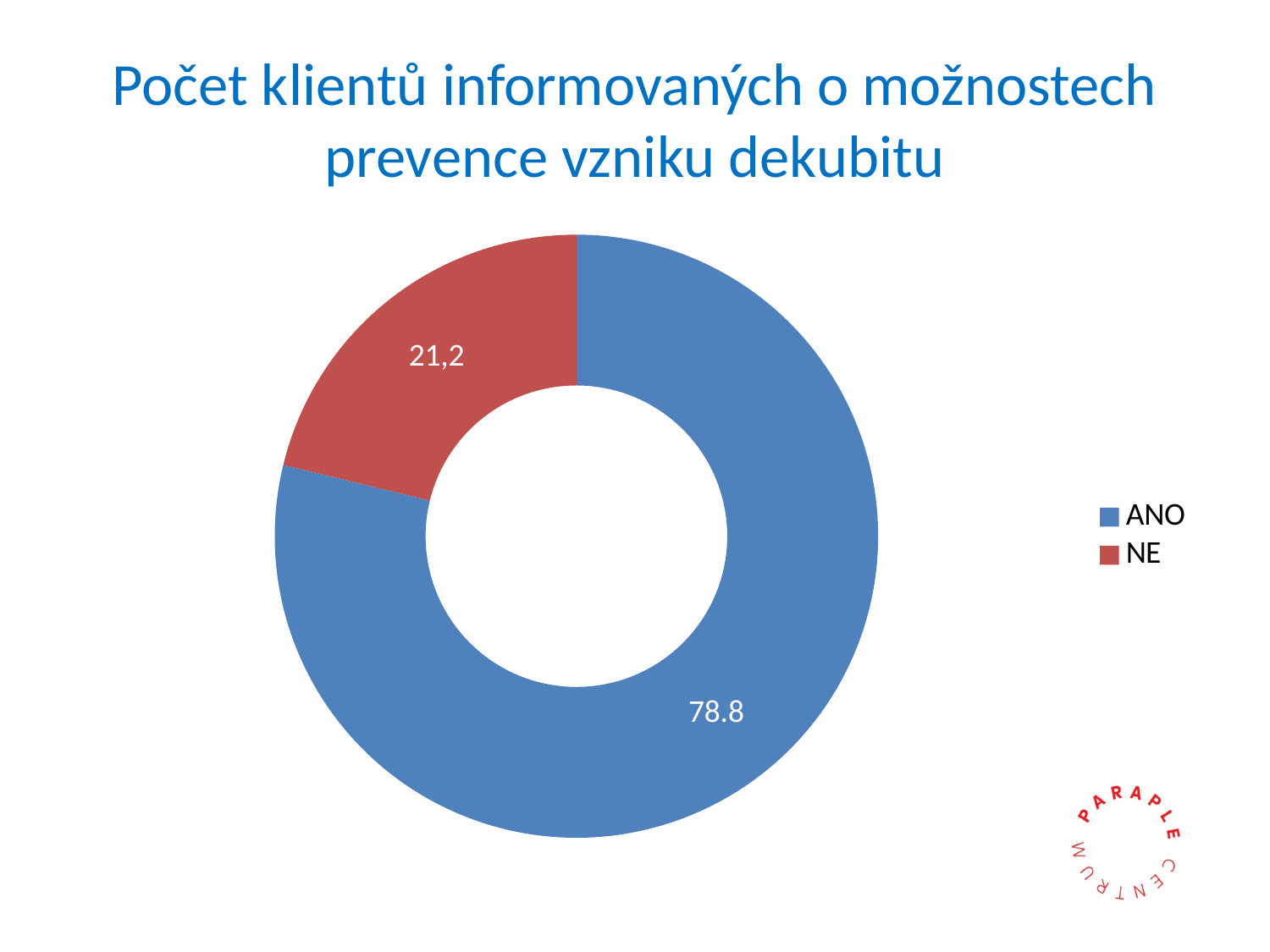
What is the title of the chart? Počet klientů informovaných o možnostech prevence vzniku dekubitu Which is larger, the value for ANO or the value for NE? ANO What value is shown for NE? 21,2 Which category has the smallest slice? NE How many entries does the legend list? 2 What value is shown for ANO? 78.8 Which category has the largest slice? ANO How many categories does the chart show? 2 What kind of chart is shown on the slide? Doughnut (pie) chart What colour is the slice for NE? Red